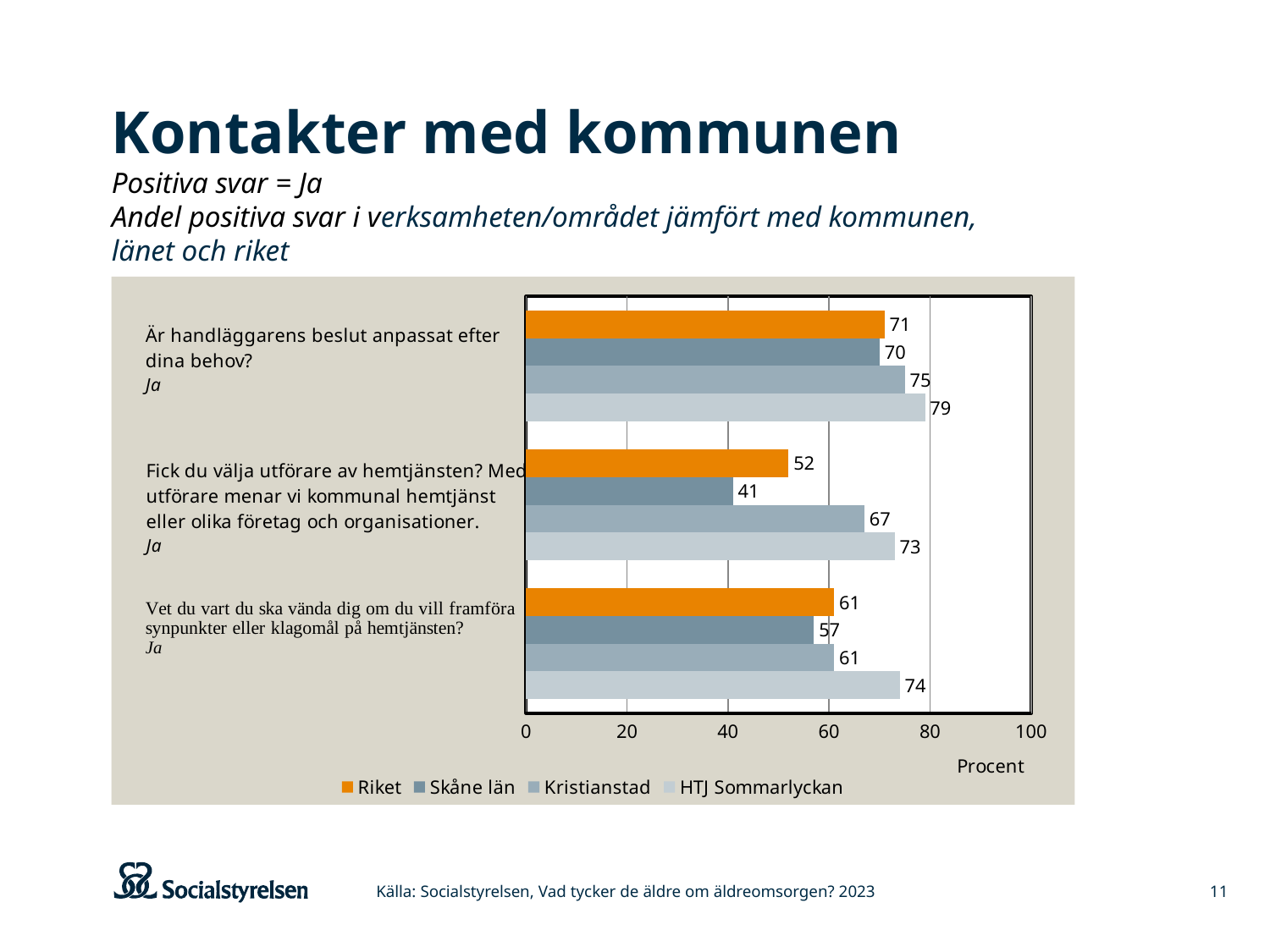
How many series does the legend list? 4 Is the value for Skåne län for the question "Fick du välja utförare av hemtjänsten?" greater or less than 60? less How many question categories are plotted on the chart? 3 Which series has the lowest value for the question "Vet du vart du ska vända dig om du vill framföra synpunkter eller klagomål på hemtjänsten?"? Skåne län What is the value for HTJ Sommarlyckan for the question "Är handläggarens beslut anpassat efter dina behov?"? 79 What is the value for Riket for the question "Vet du vart du ska vända dig om du vill framföra synpunkter eller klagomål på hemtjänsten?"? 61 What label is shown on the horizontal axis of the chart? Procent What is the value for Skåne län for the question "Fick du välja utförare av hemtjänsten?"? 41 Which series has the highest value for the question "Fick du välja utförare av hemtjänsten?"? HTJ Sommarlyckan What is the difference between HTJ Sommarlyckan and Skåne län for the question "Fick du välja utförare av hemtjänsten?"? 32 For the question "Är handläggarens beslut anpassat efter dina behov?", which is larger: the value for Kristianstad or the value for Riket? Kristianstad What kind of chart is shown on the slide? bar chart